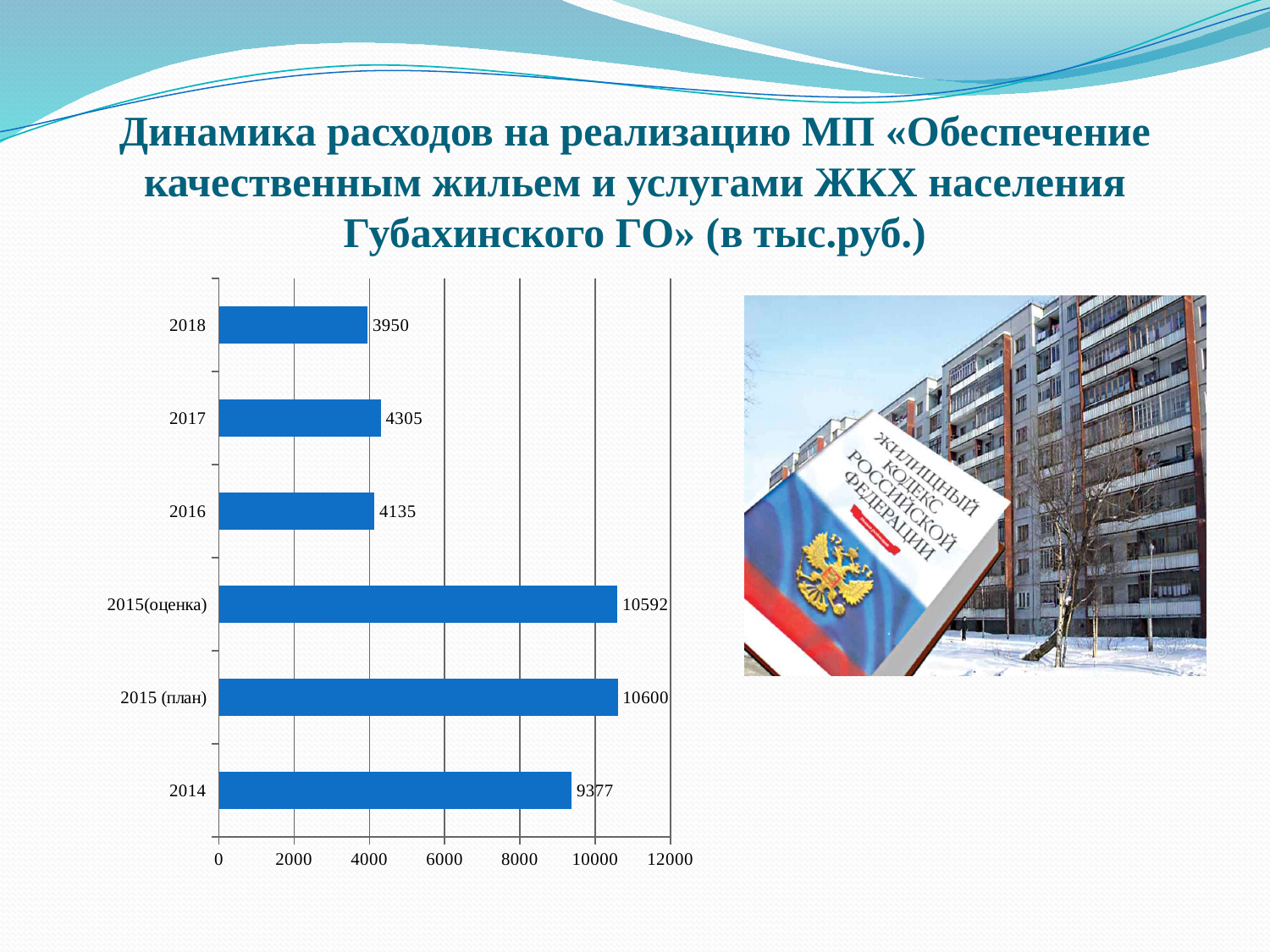
Which category has the lowest value? 2018 What is the value for 2015 (план)? 10600 What is the difference between the values for 2015 (план) and 2015(оценка)? 8 Which is larger, the value for 2014 or the value for 2016? 2014 What is the value for 2014? 9377 How many categories are shown on the chart? 6 What is the value for 2018? 3950 What is the difference between the values for 2017 and 2016? 170 What is the maximum value shown on the horizontal axis? 12000 What colour are the bars in the chart? blue What kind of chart is shown on the slide? bar chart Is the value for 2014 greater or less than 8000? greater